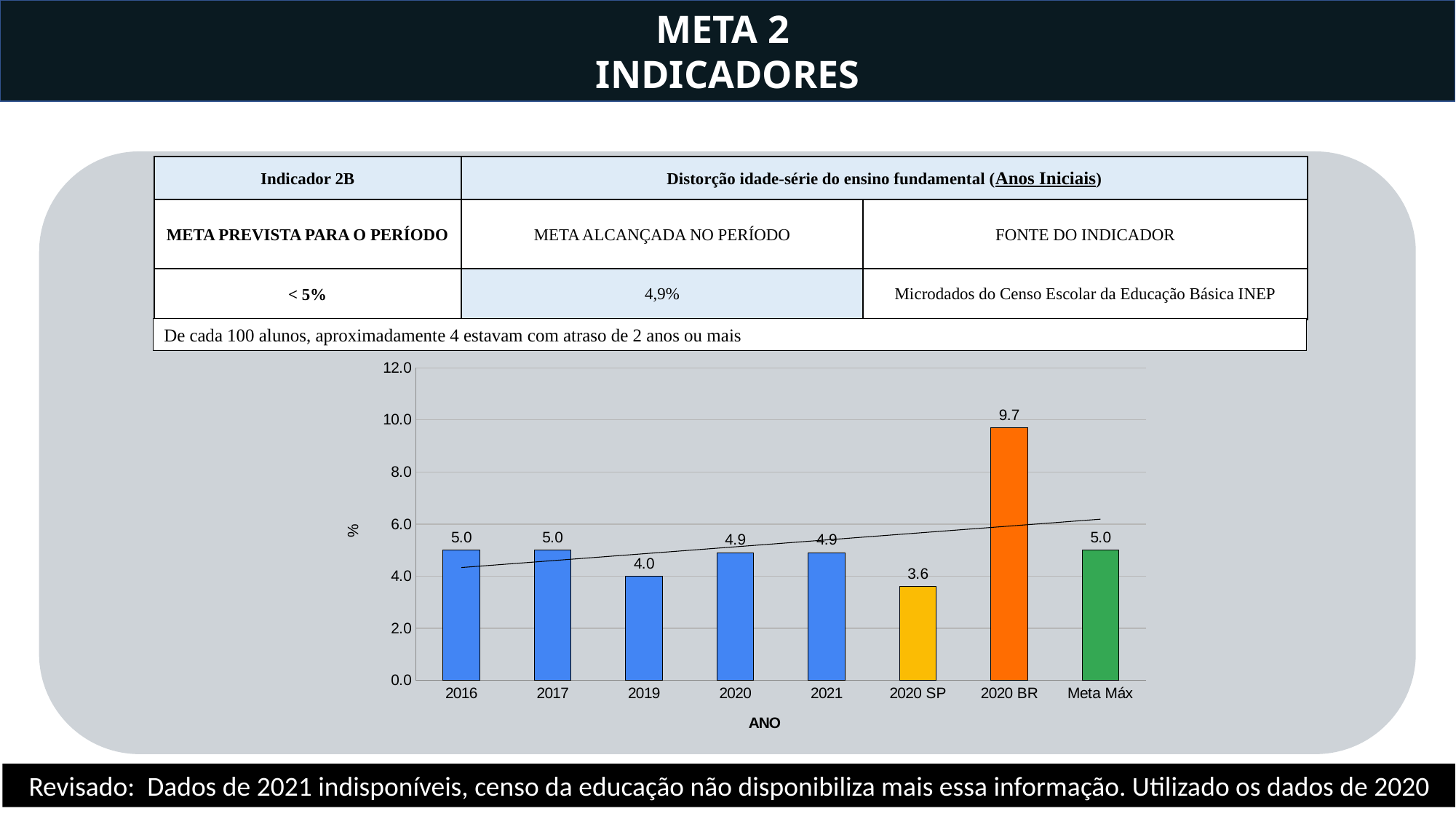
How many bars are shown in the chart? 8 What is the label of the x axis of the chart? ANO What is the difference between the values for 2020 BR and 2020 SP? 6.1 Which category has the highest value? 2020 BR Which is larger, the value for 2017 or the value for 2019? 2017 Is the value for 2020 BR greater or less than 8.0? greater What is the value for 2020 BR? 9.7 What kind of chart is shown on the slide? bar chart What is the value for 2019? 4.0 What is the value for Meta Máx? 5.0 What is the value for 2020 SP? 3.6 Which category has the lowest value? 2020 SP